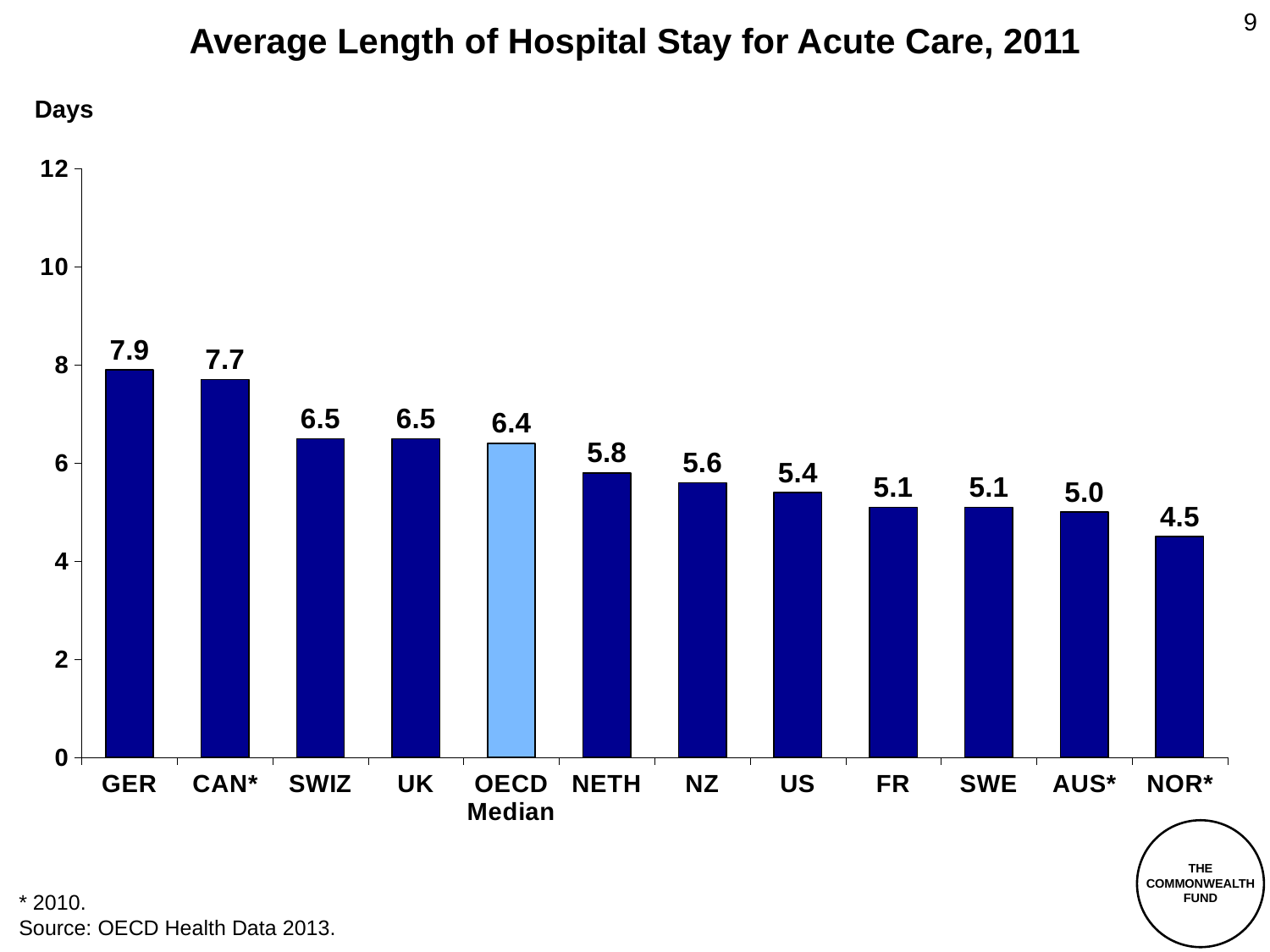
What type of chart is shown on the slide? Bar chart What is the average length of hospital stay for acute care in Germany (GER)? 7.9 Which bar is shown in a lighter blue colour than the others? OECD Median What is the difference between the values for CAN* and the US? 2.3 What is the difference between the values for GER and NOR*? 3.4 What is the average length of hospital stay for the US? 5.4 Is the value for SWIZ greater or less than 6? greater How many bars are shown in the chart? 12 Which country has the highest average length of hospital stay? GER What is the value shown for the OECD Median? 6.4 Which country has the lowest average length of hospital stay? NOR* Which has a longer average hospital stay, NETH or NZ? NETH